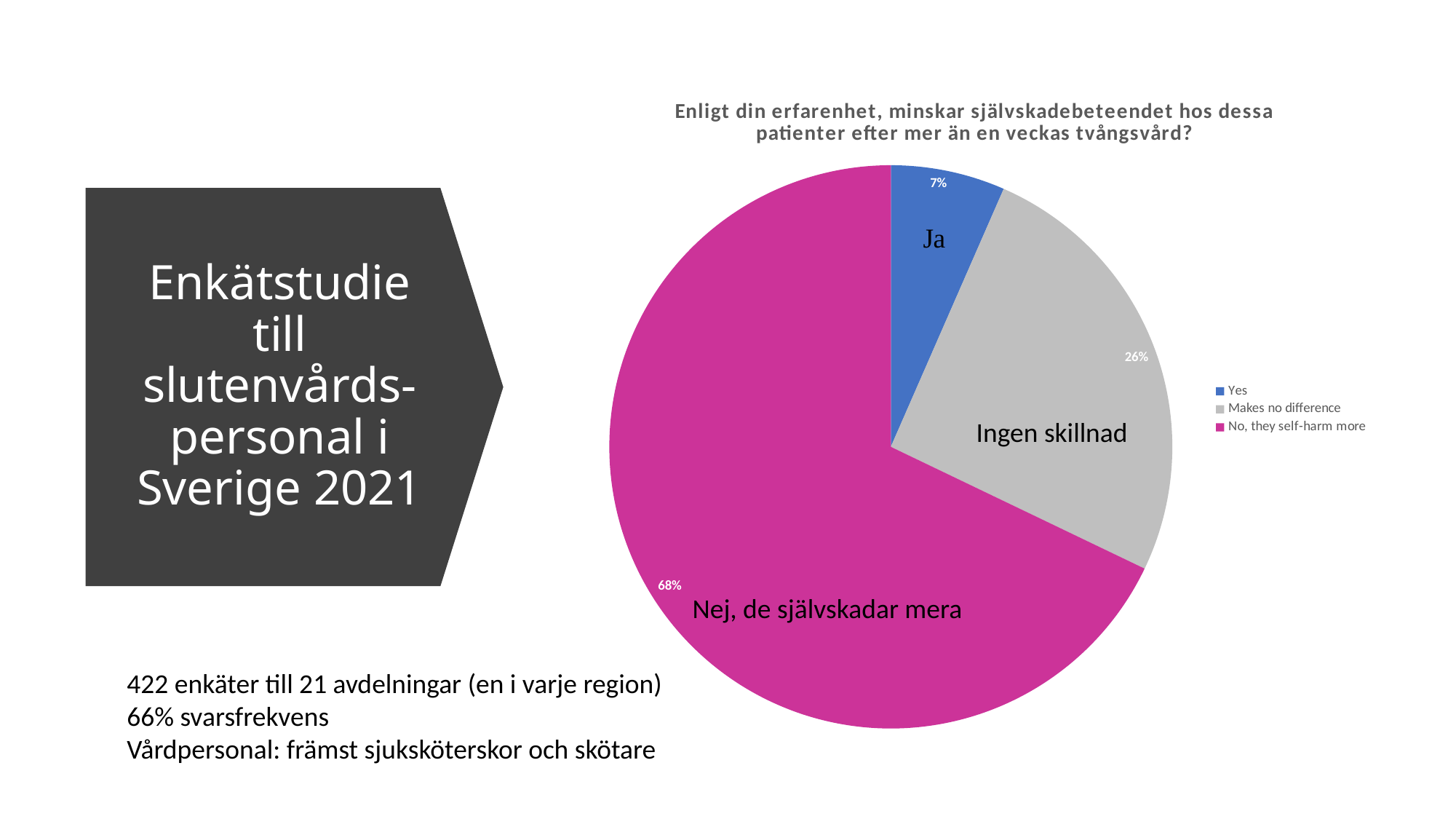
How many entries does the legend list? 3 Which category has the smallest slice of the pie? Yes What share of the pie does the "Yes" slice represent? 7% Which category has the largest slice of the pie? No, they self-harm more What is the difference in percentage points between the "Makes no difference" slice and the "Yes" slice? 19 What is the difference in percentage points between the "No, they self-harm more" slice and the "Makes no difference" slice? 42 What kind of chart is shown on the slide? pie chart What share of the pie does the "Makes no difference" slice represent? 26% Which is larger, the "Makes no difference" slice or the "Yes" slice? Makes no difference What colour is the "No, they self-harm more" slice? magenta What share of the pie does the "No, they self-harm more" slice represent? 68% How many slices does the pie chart have? 3